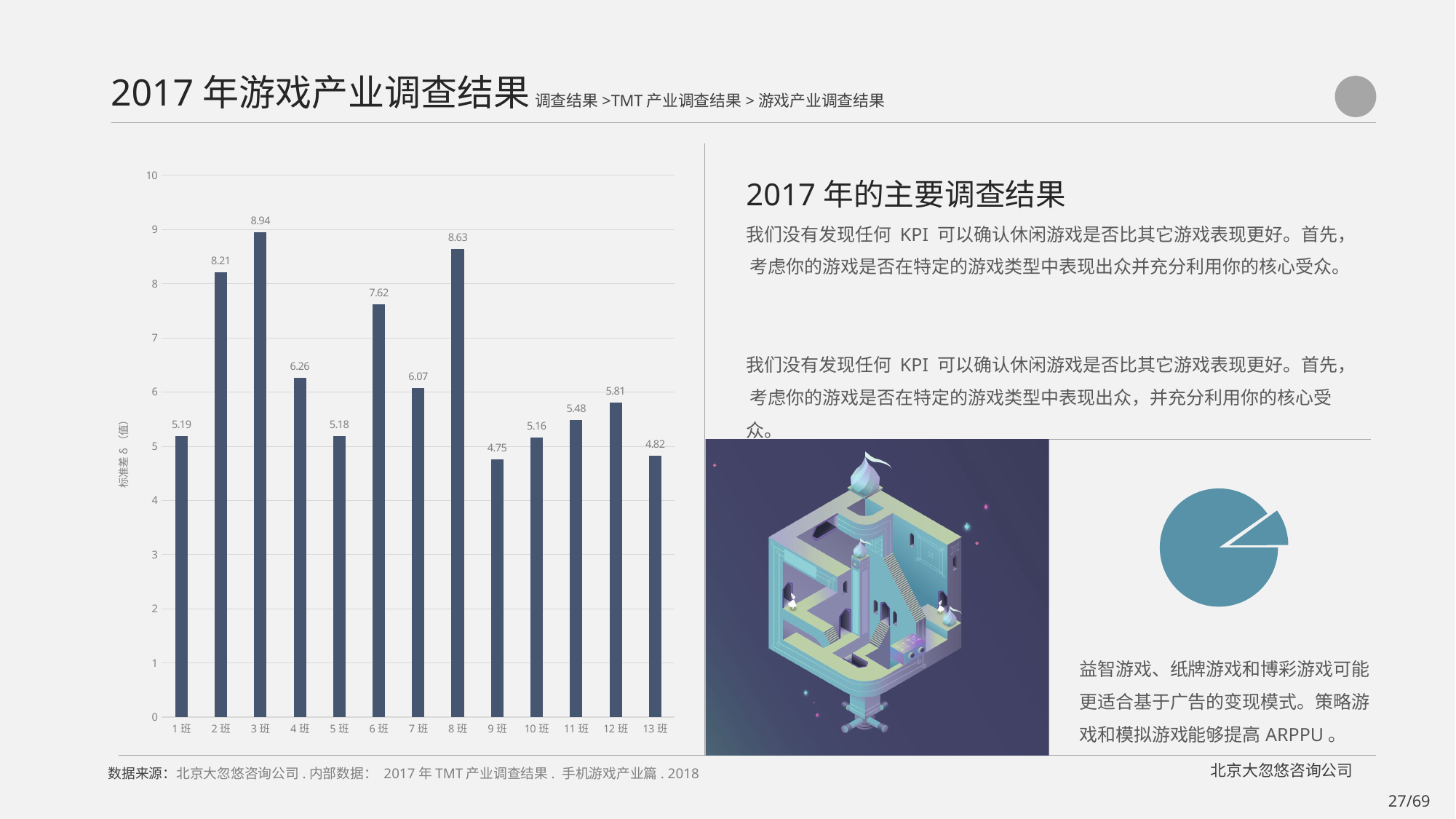
How many categories are shown on the x axis of the bar chart? 13 What is the value for 9班 in the bar chart? 4.75 What kind of chart is the chart on the left of the slide? bar chart Which has a larger value in the bar chart, 2班 or 8班? 8班 What is the value for 3班 in the bar chart? 8.94 Which category has the lowest value in the bar chart? 9班 Is the value for 4班 in the bar chart greater or less than 6? greater What is the label on the vertical axis of the bar chart? 标准差 δ（值） Which category has the highest value in the bar chart? 3班 What is the difference between the values for 3班 and 9班 in the bar chart? 4.19 What is the value for 6班 in the bar chart? 7.62 What is the value for 13班 in the bar chart? 4.82